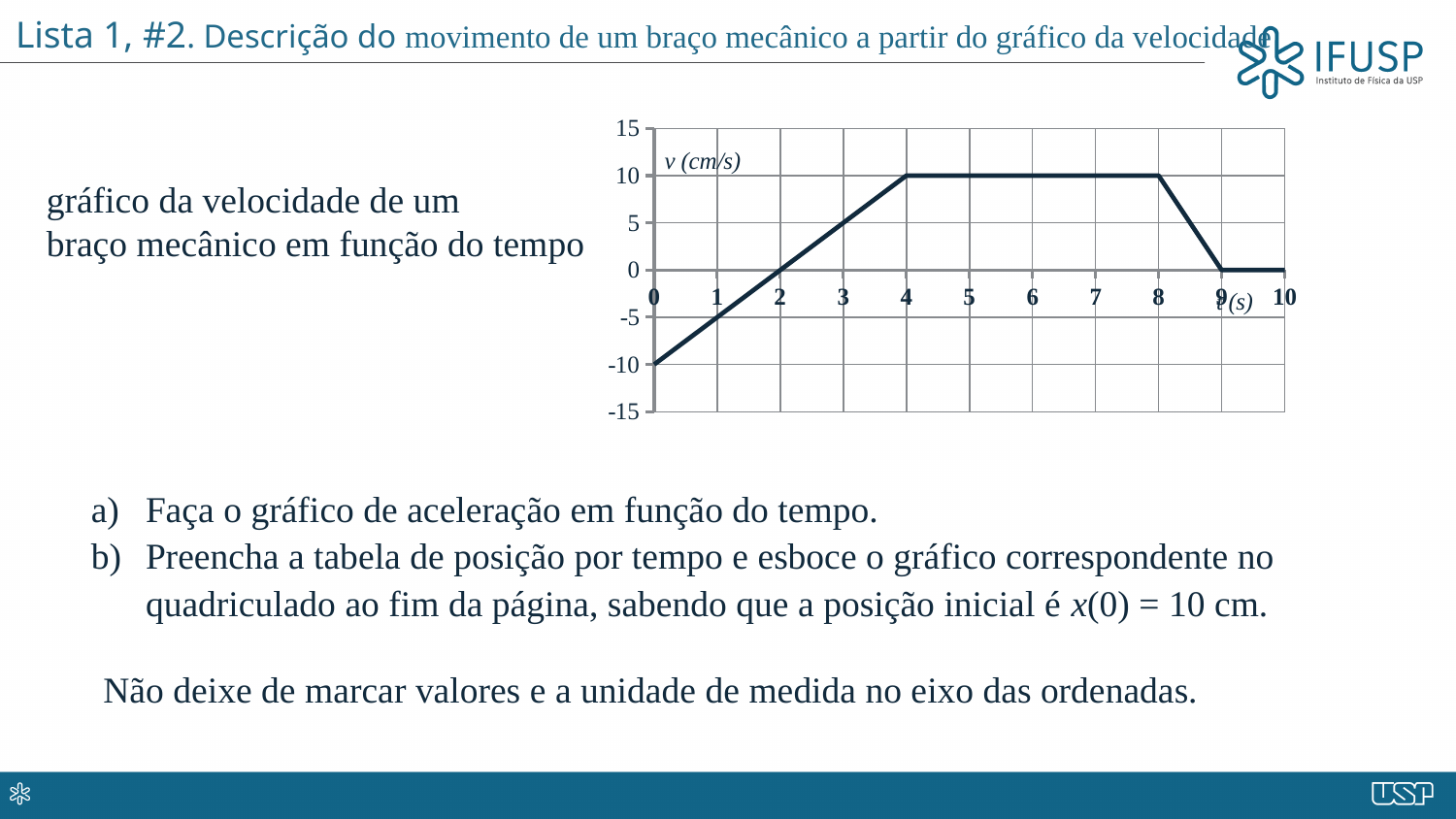
What is the velocity at t = 1 s? -5 What is the velocity at t = 8 s? 10 What is the highest velocity value reached on the graph? 10 Does the velocity rise or fall between t = 0 s and t = 4 s? rise What is the label of the vertical axis? v (cm/s) What type of chart is shown on the slide? line chart What is the velocity at t = 0 s? -10 By how much does the velocity change between t = 0 s and t = 4 s? 20 What is the velocity at t = 9 s? 0 What is the velocity at t = 4 s? 10 What is the lowest velocity value on the graph? -10 Is the velocity at t = 6 s greater or less than 5? greater